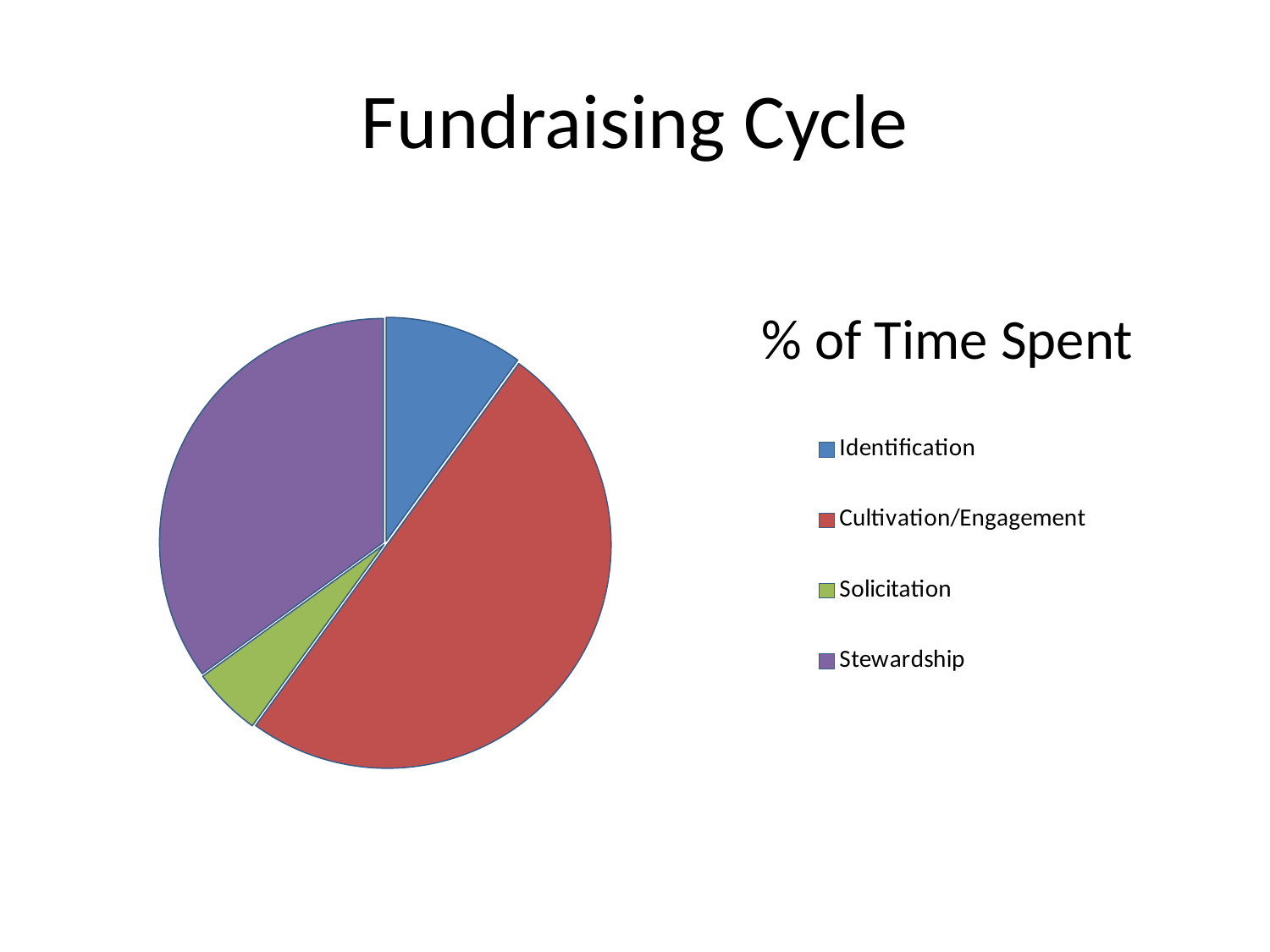
Which slice is larger, Identification or Solicitation? Identification Which category takes up the largest share of the pie? Cultivation/Engagement What kind of chart is shown on the slide? pie chart Which category takes up the smallest share of the pie? Solicitation Which slice is larger, Cultivation/Engagement or Stewardship? Cultivation/Engagement Which slice is larger, Stewardship or Identification? Stewardship How many categories (slices) does the pie chart have? 4 What is the title of the chart? % of Time Spent How many entries does the legend list? 4 Which category is shown in purple in the pie chart? Stewardship